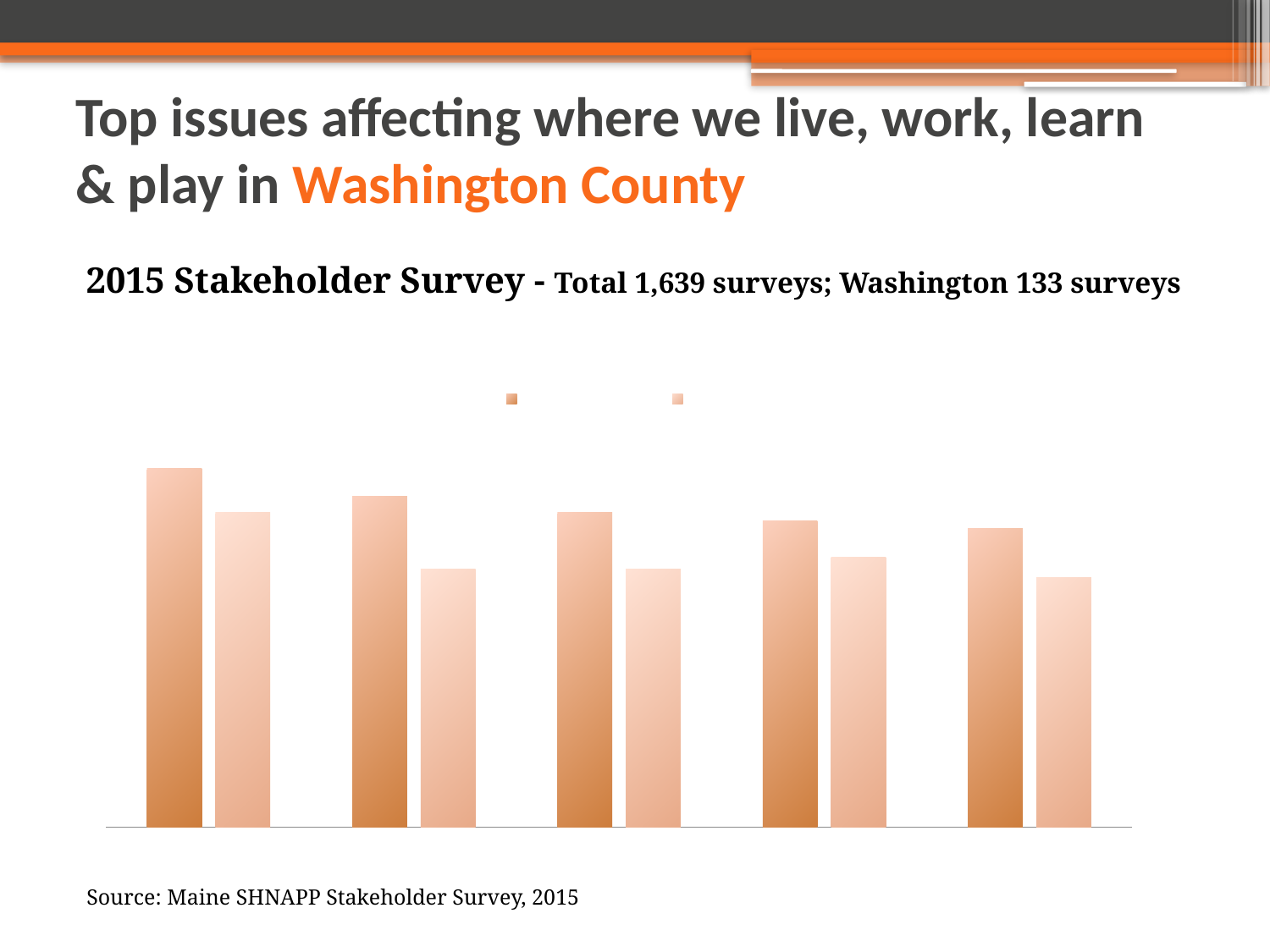
Are the bars in the chart vertical or horizontal? vertical How many series does the chart's legend list? 2 How many groups of bars are plotted in the chart? 5 Which group of bars, counting from the left, contains the tallest bar in the chart? the first group Do the values of the darker orange series rise or fall from left to right across the chart? fall In each group of bars, is the darker orange bar or the lighter orange bar taller? the darker orange bar What colours are used for the two series in the chart? dark orange and light orange What kind of chart is shown on the slide? bar chart